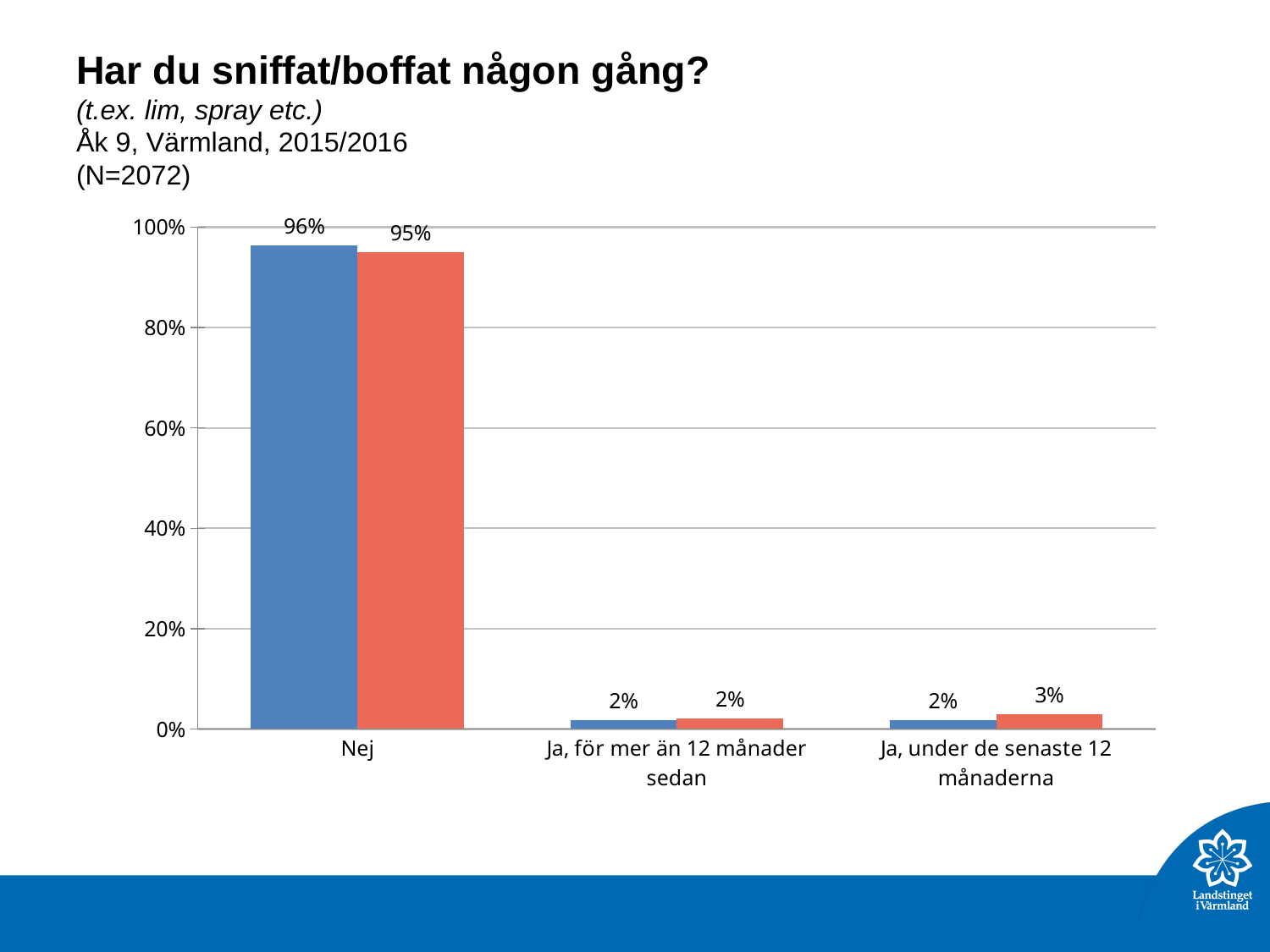
What is the value of the red bar for "Nej"? 95% What is the title of the chart on the slide? Har du sniffat/boffat någon gång? What is the value of the blue bar for "Nej"? 96% Is the value of the blue bar for "Nej" greater or less than 80%? greater What is the difference between the blue bar and the red bar for "Nej"? 1% Which category has the highest blue bar? Nej How many categories are shown on the x axis? 3 What is the difference between the red bar and the blue bar for "Ja, under de senaste 12 månaderna"? 1% What kind of chart is shown on the slide? bar chart For "Ja, under de senaste 12 månaderna", is the blue bar or the red bar larger? red What is the value of the blue bar for "Ja, för mer än 12 månader sedan"? 2% What is the value of the red bar for "Ja, under de senaste 12 månaderna"? 3%